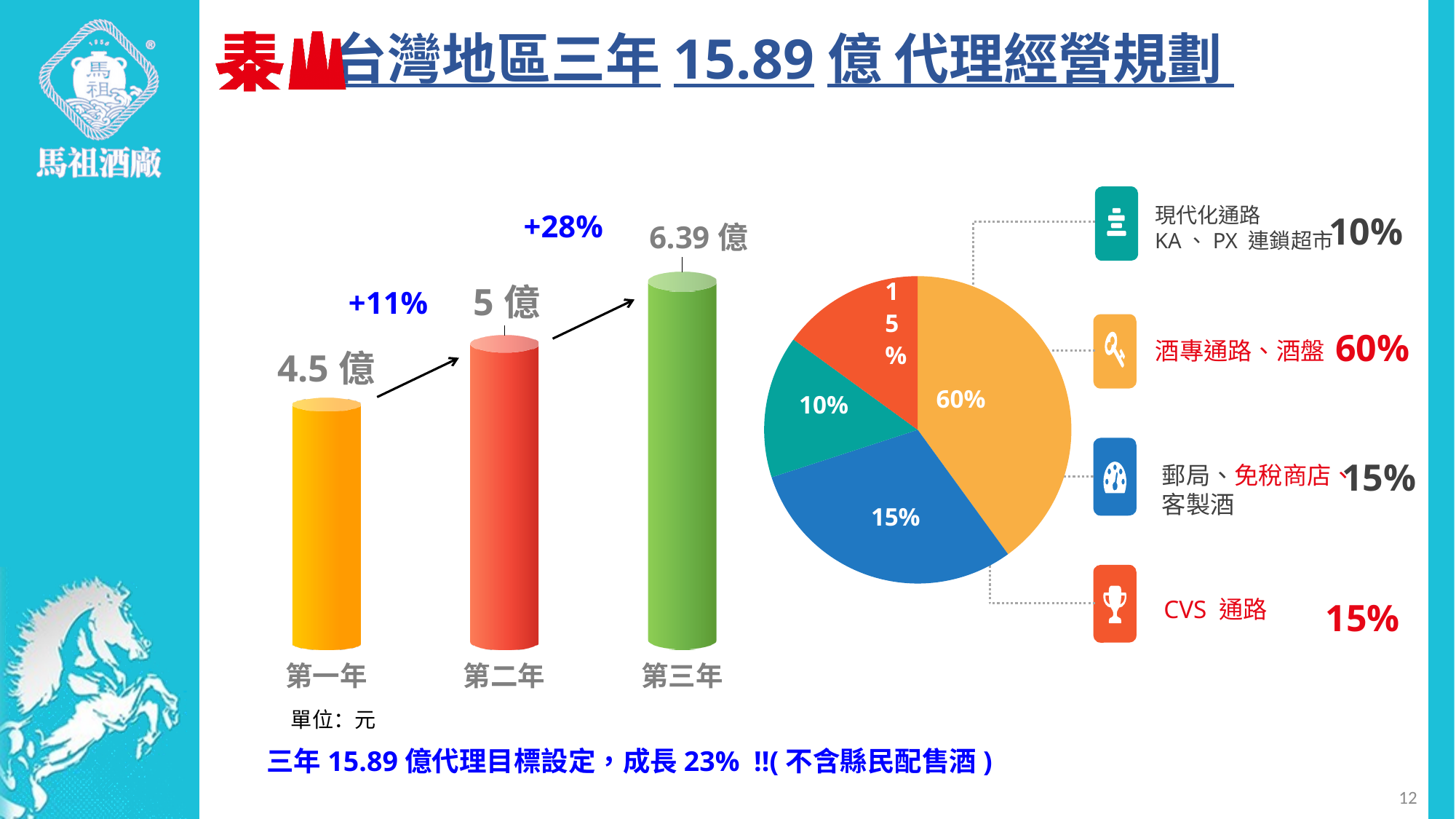
In the pie chart on the right, what share does 現代化通路 (KA、PX 連鎖超市) have? 10% What kind of chart is the chart on the left of the slide? bar chart In the bar chart on the left, what growth percentage is shown between 第二年 and 第三年? +28% In the pie chart on the right, what share does 酒專通路、酒盤 have? 60% In the bar chart on the left, what is the value for 第三年? 6.39 億 In the bar chart on the left, what is the value for 第一年? 4.5 億 In the pie chart on the right, how many slices are there? 4 In the bar chart on the left, which year has the lowest value? 第一年 In the bar chart on the left, do the values rise or fall from 第一年 to 第三年? rise In the bar chart on the left, what is the difference between the values for 第三年 and 第二年? 1.39 億 In the bar chart on the left, how many years are shown? 3 In the bar chart on the left, which year has the highest value? 第三年